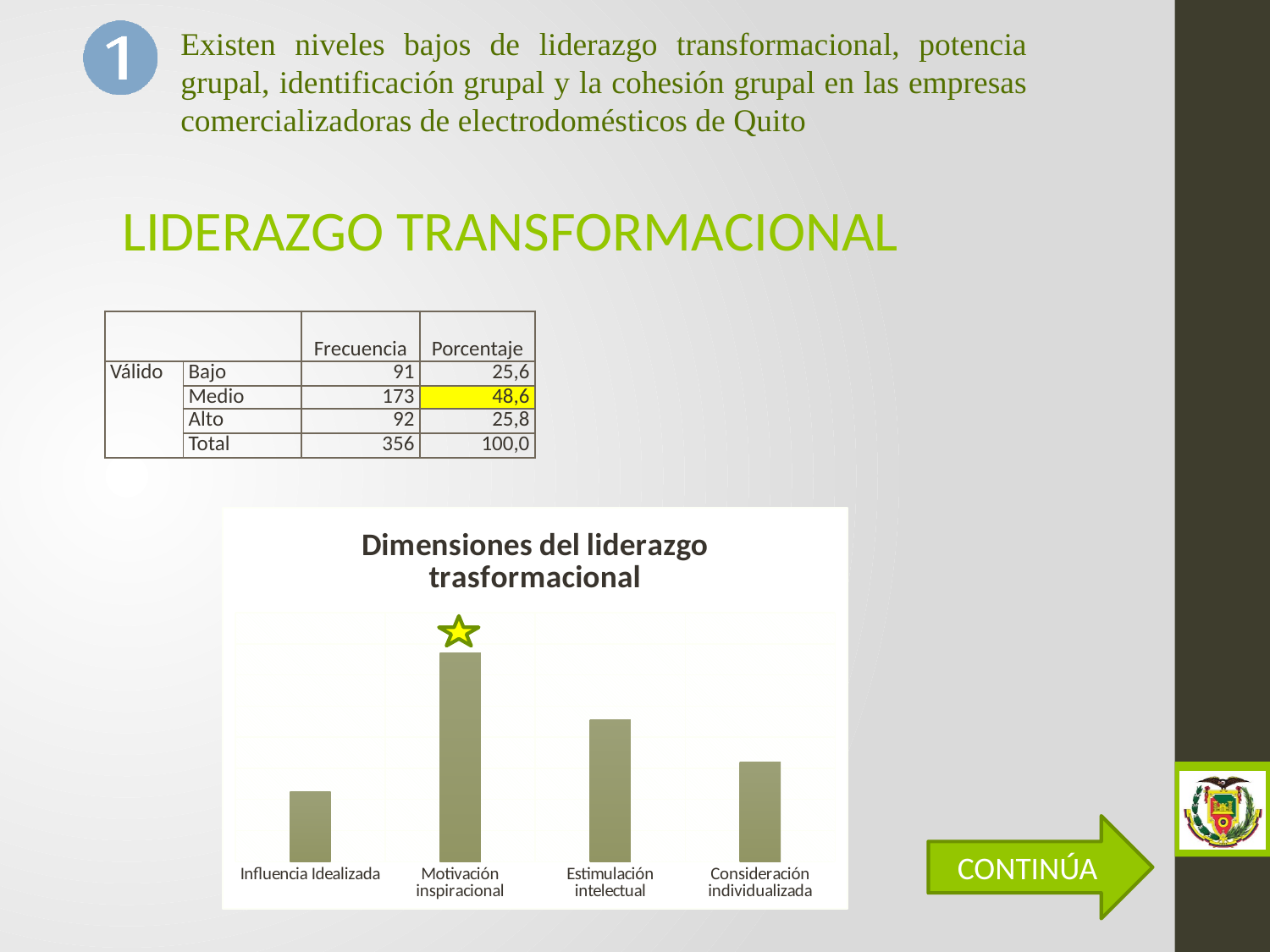
How many categories are plotted in the "Dimensiones del liderazgo trasformacional" chart? 4 In the "Dimensiones del liderazgo trasformacional" chart, which is larger: Motivación inspiracional or Estimulación intelectual? Motivación inspiracional Which category has the lowest bar in the "Dimensiones del liderazgo trasformacional" chart? Influencia Idealizada Which bar in the "Dimensiones del liderazgo trasformacional" chart is marked with a star? Motivación inspiracional What is the label of the second category from the left in the "Dimensiones del liderazgo trasformacional" chart? Motivación inspiracional What is the title of the bar chart on the slide? Dimensiones del liderazgo trasformacional In the "Dimensiones del liderazgo trasformacional" chart, which is larger: Influencia Idealizada or Consideración individualizada? Consideración individualizada What kind of chart is shown under the title "Dimensiones del liderazgo trasformacional"? bar chart Do the bars in the "Dimensiones del liderazgo trasformacional" chart rise or fall from Motivación inspiracional to Consideración individualizada? fall Which category has the highest bar in the "Dimensiones del liderazgo trasformacional" chart? Motivación inspiracional In the "Dimensiones del liderazgo trasformacional" chart, which is larger: Estimulación intelectual or Consideración individualizada? Estimulación intelectual